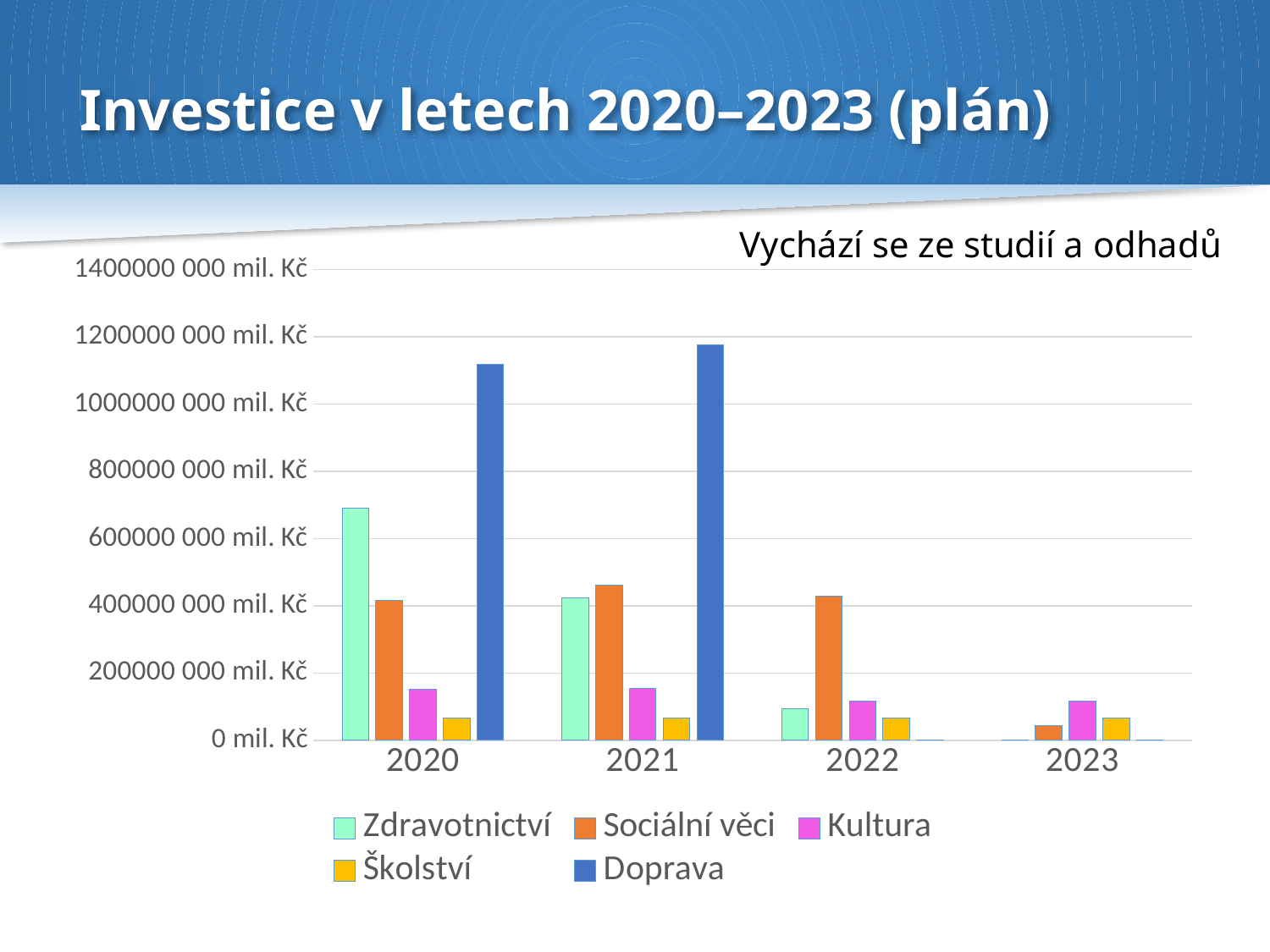
Is the value for Kultura in 2020 greater or less than 200000 000 mil. Kč? less How many years are shown on the x axis of the chart? 4 Which is larger: Doprava in 2020 or Doprava in 2021? Doprava in 2021 What is the title of the slide containing the chart? Investice v letech 2020–2023 (plán) Which series has the highest bar in 2022? Sociální věci How many series does the chart legend list? 5 In 2021, which is larger: Sociální věci or Zdravotnictví? Sociální věci What kind of chart is shown on the slide? bar chart Does the value for Zdravotnictví rise or fall from 2020 to 2023? fall Is the value for Doprava in 2020 greater or less than 1000000 000 mil. Kč? greater Is the value for Zdravotnictví in 2020 greater or less than 600000 000 mil. Kč? greater In which year is the Doprava bar the highest? 2021